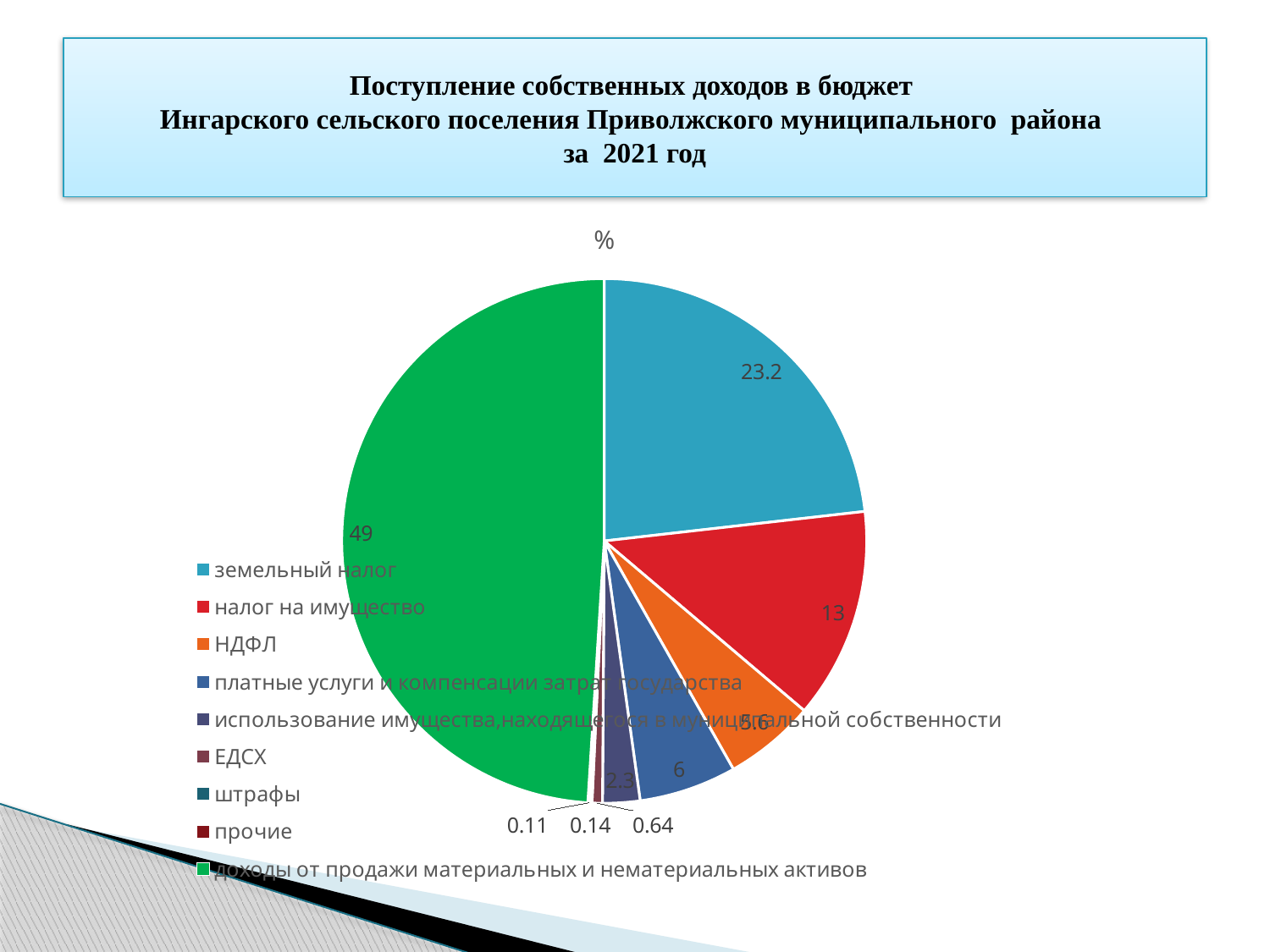
What is the value for налог на имущество? 13 What is the value for использование имущества,находящегося в муниципальной собственности? 2.3 Which is larger, земельный налог or налог на имущество? земельный налог What is the value for доходы от продажи материальных и нематериальных активов? 49 What is the value for платные услуги и компенсации затрат государства? 6 What is the title shown above the pie chart? % How many categories does the legend list? 9 Which category has the largest slice of the pie? доходы от продажи материальных и нематериальных активов What is the difference between the values for земельный налог and налог на имущество? 10.2 What is the value for земельный налог? 23.2 What type of chart is shown on the slide? pie chart What is the difference between the values for доходы от продажи материальных и нематериальных активов and земельный налог? 25.8